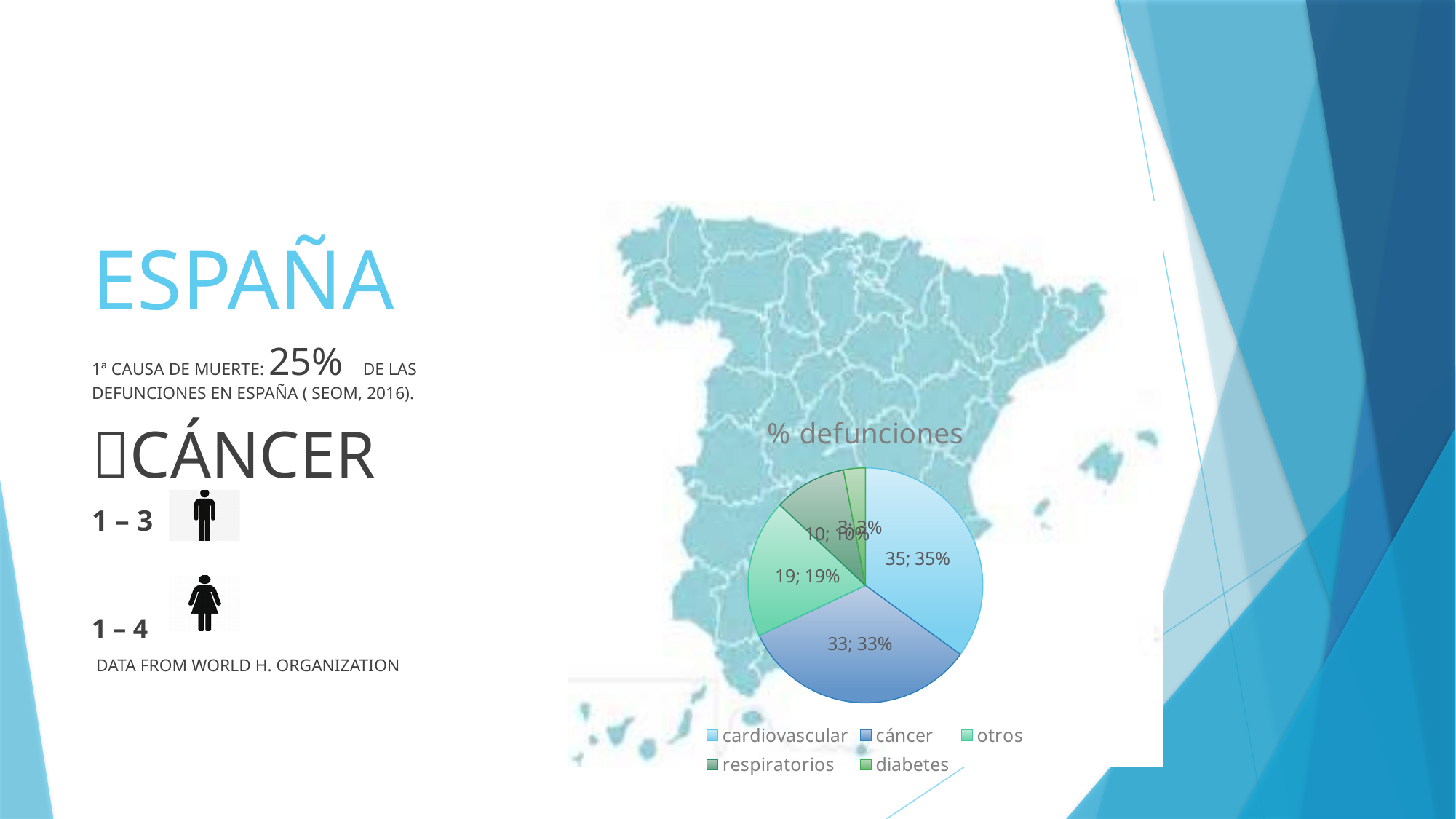
Which slice is larger, otros or respiratorios? otros By how many percentage points does the cardiovascular share exceed the cáncer share? 2 What percentage of the pie does the respiratorios slice represent? 10% How many categories does the pie chart's legend list? 5 What percentage of the pie does the cardiovascular slice represent? 35% Which category has the smallest slice of the pie? diabetes Which category has the largest slice of the pie? cardiovascular What percentage of the pie does the otros slice represent? 19% What kind of chart is shown on the slide? pie chart What is the title of the pie chart? % defunciones What data label is printed on the cáncer slice? 33; 33%